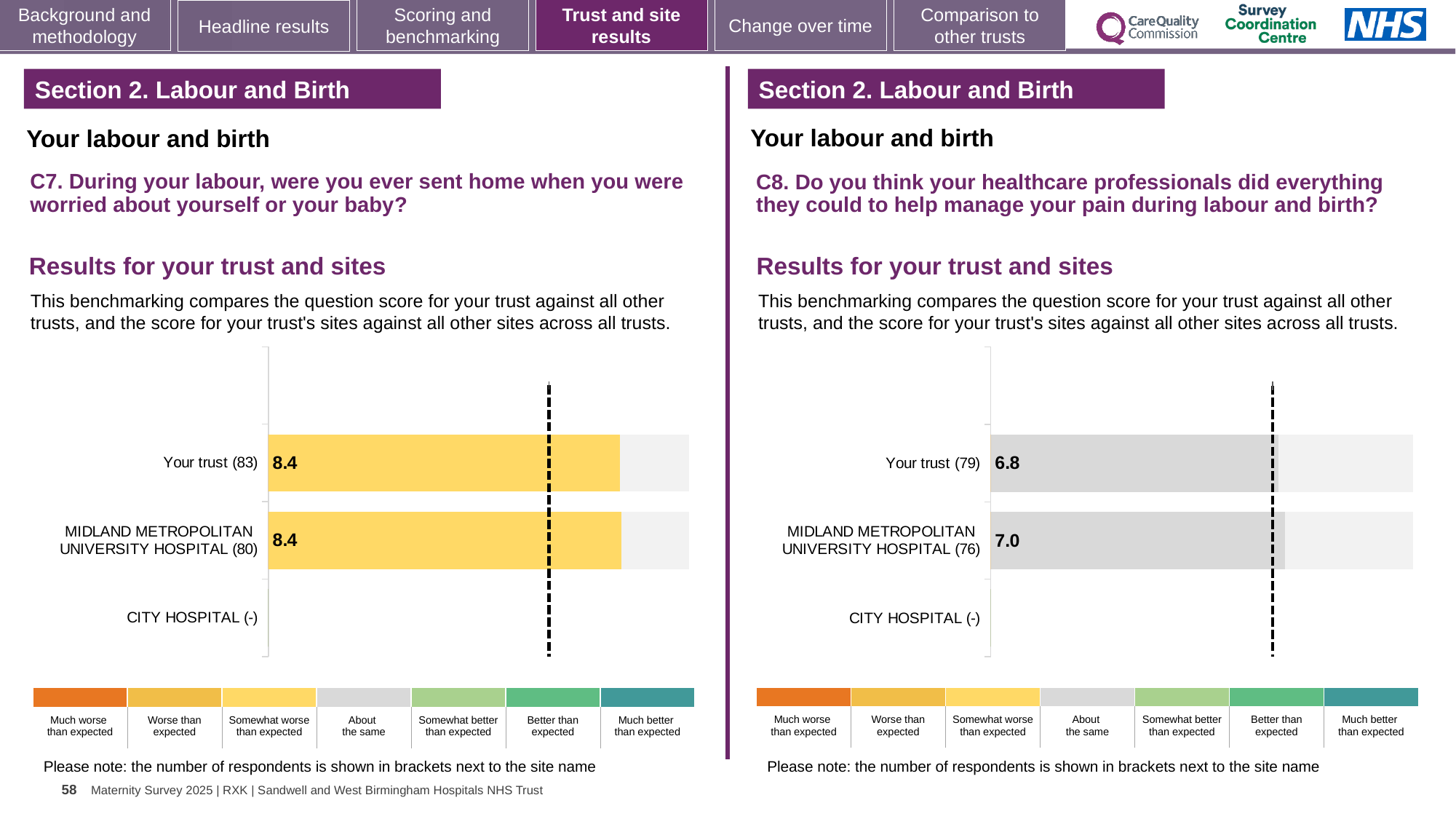
What kind of chart is used in the right chart (C8)? Bar chart In the left chart (C7), which benchmark category does the yellow colour of the bars correspond to in the legend? Somewhat worse than expected In the right chart (C8), what is the difference between the Midland Metropolitan University Hospital score and the Your trust score? 0.2 In the right chart (C8), which has the higher score: Your trust or Midland Metropolitan University Hospital? Midland Metropolitan University Hospital In the right chart (C8), how many respondents are shown in brackets for Midland Metropolitan University Hospital? 76 In the right chart (C8), which benchmark category does the grey colour of the bars correspond to in the legend? About the same In the right chart (C8), what is the score for Your trust? 6.8 In the right chart (C8), what is the score for Midland Metropolitan University Hospital? 7.0 In the left chart (C7), what is the score for Midland Metropolitan University Hospital? 8.4 In the left chart (C7), what is the score for Your trust? 8.4 How many site/trust categories are listed on the y axis of the left chart (C7)? 3 In the left chart (C7), how many respondents are shown in brackets for Your trust? 83